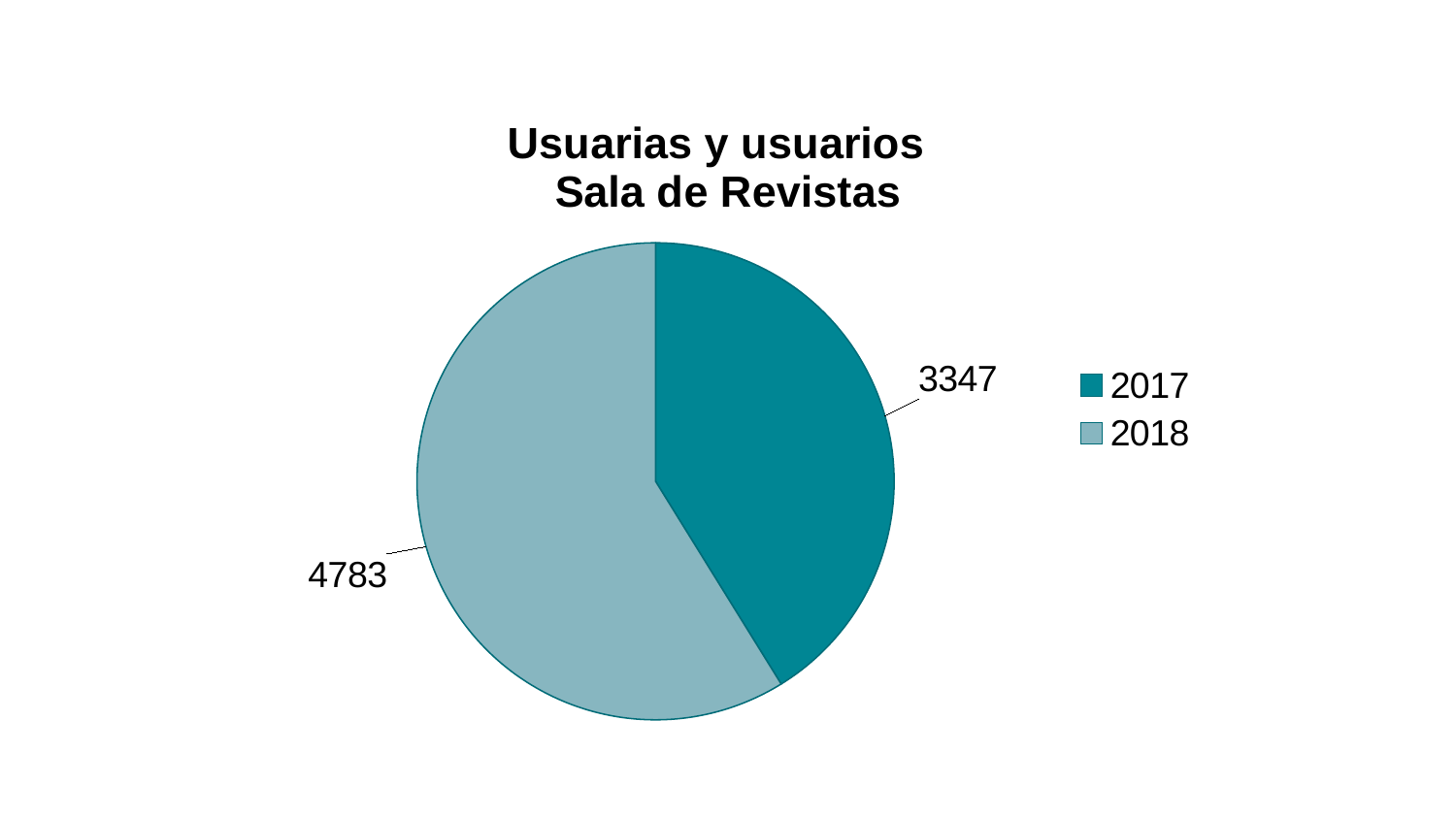
What kind of chart is shown on the slide? pie chart What is the difference between the values for 2018 and 2017? 1436 Is the value for 2017 larger or smaller than the value for 2018? smaller How many entries does the legend list? 2 How many slices does the pie chart have? 2 What share of the pie does the 2018 slice represent, to one decimal place? 58.8% What is the value for 2017 in the pie chart? 3347 Which year has the larger slice of the pie? 2018 What is the title of the chart? Usuarias y usuarios Sala de Revistas Which year has the smaller slice of the pie? 2017 What is the total of the two slices in the pie chart? 8130 What is the value for 2018 in the pie chart? 4783